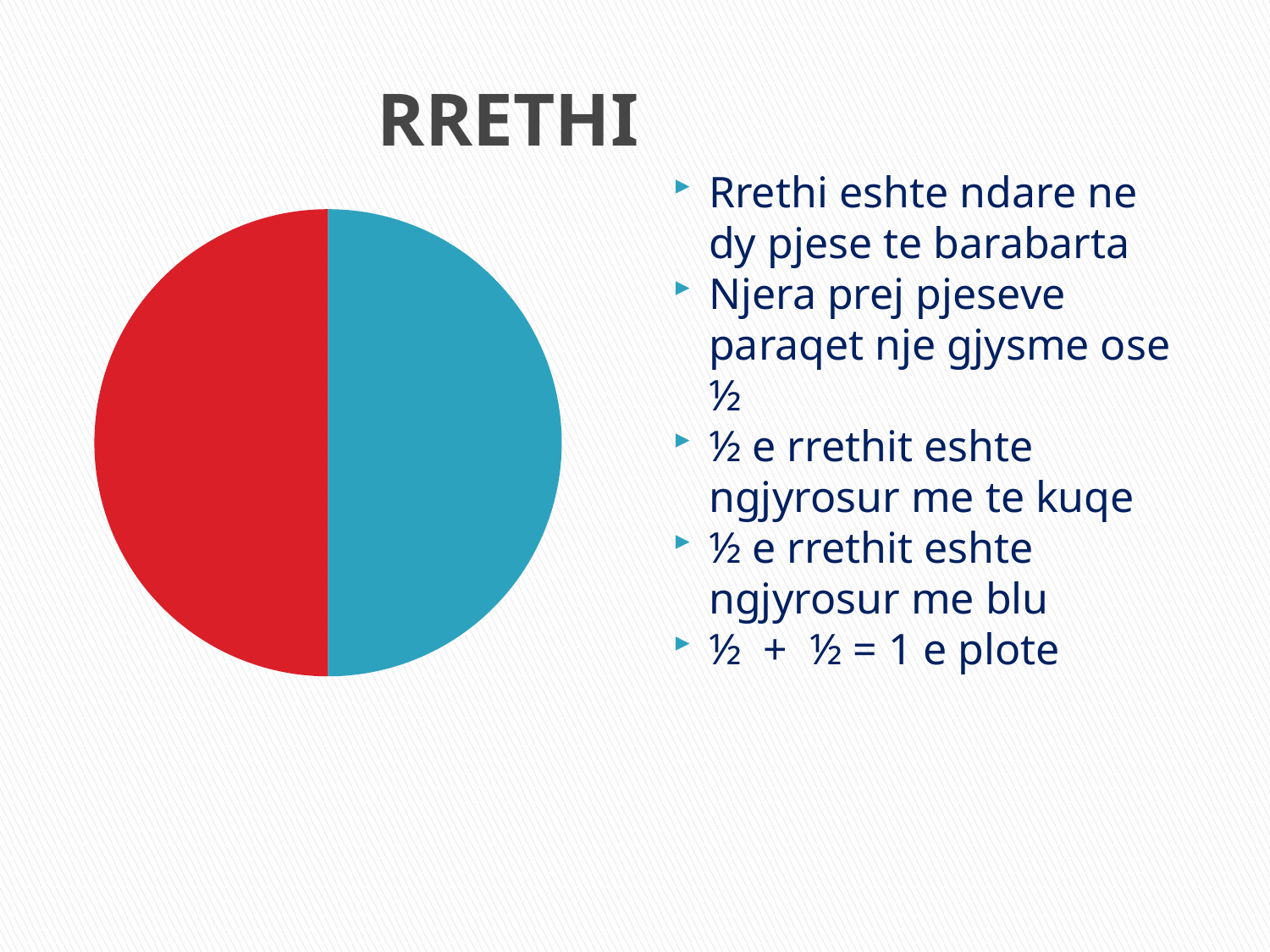
What is the total of the two halves of the circle, as stated on the slide? 1 What is the title of the slide containing the pie chart? RRETHI How many slices does the pie chart have? 2 What share of the circle is coloured blue? ½ What kind of chart is shown on the slide? pie chart What two colours are used for the slices of the pie chart? red and blue What share of the circle is coloured red? ½ Are the red and blue slices of the pie chart equal in size? yes